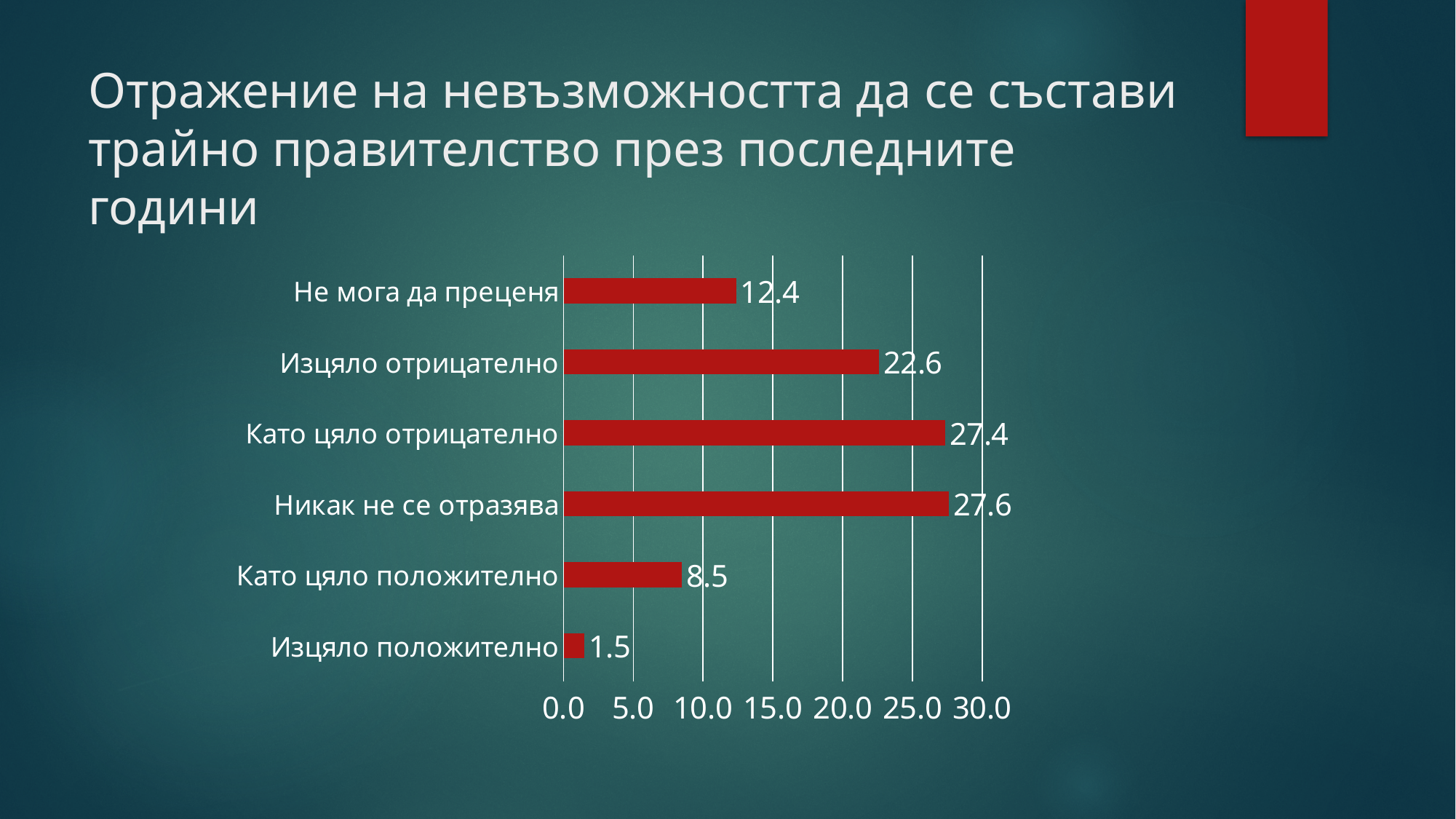
Which category has the lowest value? Изцяло положително What is the difference between the values for "Като цяло отрицателно" and "Като цяло положително"? 18.9 Which category has the highest value? Никак не се отразява What is the value for "Изцяло положително"? 1.5 What is the value for "Не мога да преценя"? 12.4 What is the difference between the values for "Изцяло отрицателно" and "Не мога да преценя"? 10.2 How many categories are shown in the chart? 6 What is the value for "Като цяло положително"? 8.5 Which is larger, the value for "Като цяло отрицателно" or the value for "Като цяло положително"? Като цяло отрицателно What kind of chart is shown on the slide? bar chart Is the value for "Изцяло отрицателно" greater or less than 20.0? greater What is the value for "Изцяло отрицателно"? 22.6